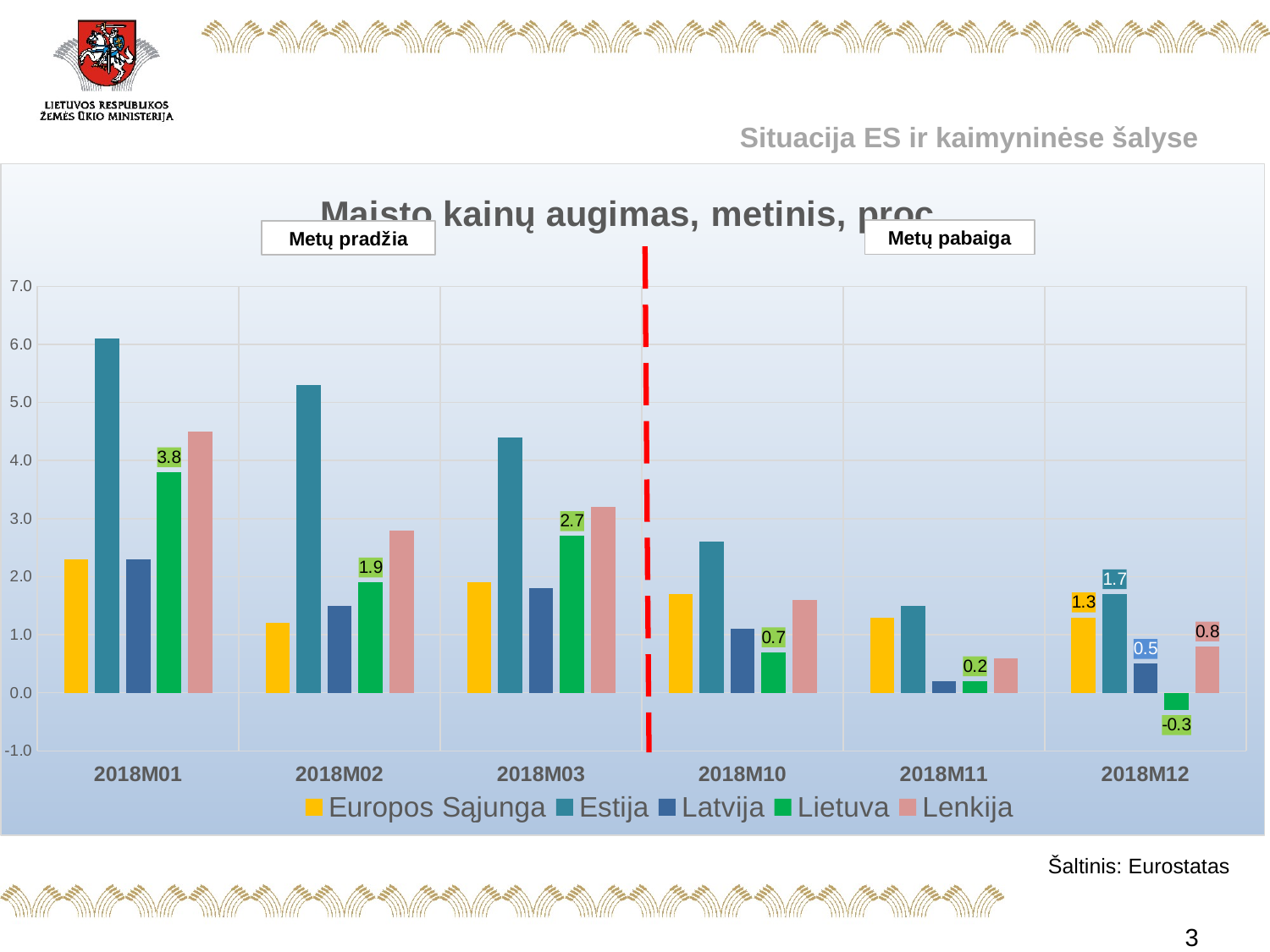
What is the value for Lietuva in 2018M01? 3.8 Which series has the highest value in 2018M12? Estija How many time periods are shown on the x axis? 6 Which is larger for Lietuva: the value in 2018M02 or in 2018M03? 2018M03 What is the value for Estija in 2018M12? 1.7 What is the difference between the Lietuva values for 2018M01 and 2018M03? 1.1 What kind of chart is shown on the slide? Bar chart What is the value for Lenkija in 2018M12? 0.8 How many series does the legend list? 5 Is the value for Estija in 2018M01 greater or less than 5.0? greater Which series has the lowest value in 2018M12? Lietuva What is the value for Lietuva in 2018M12? -0.3